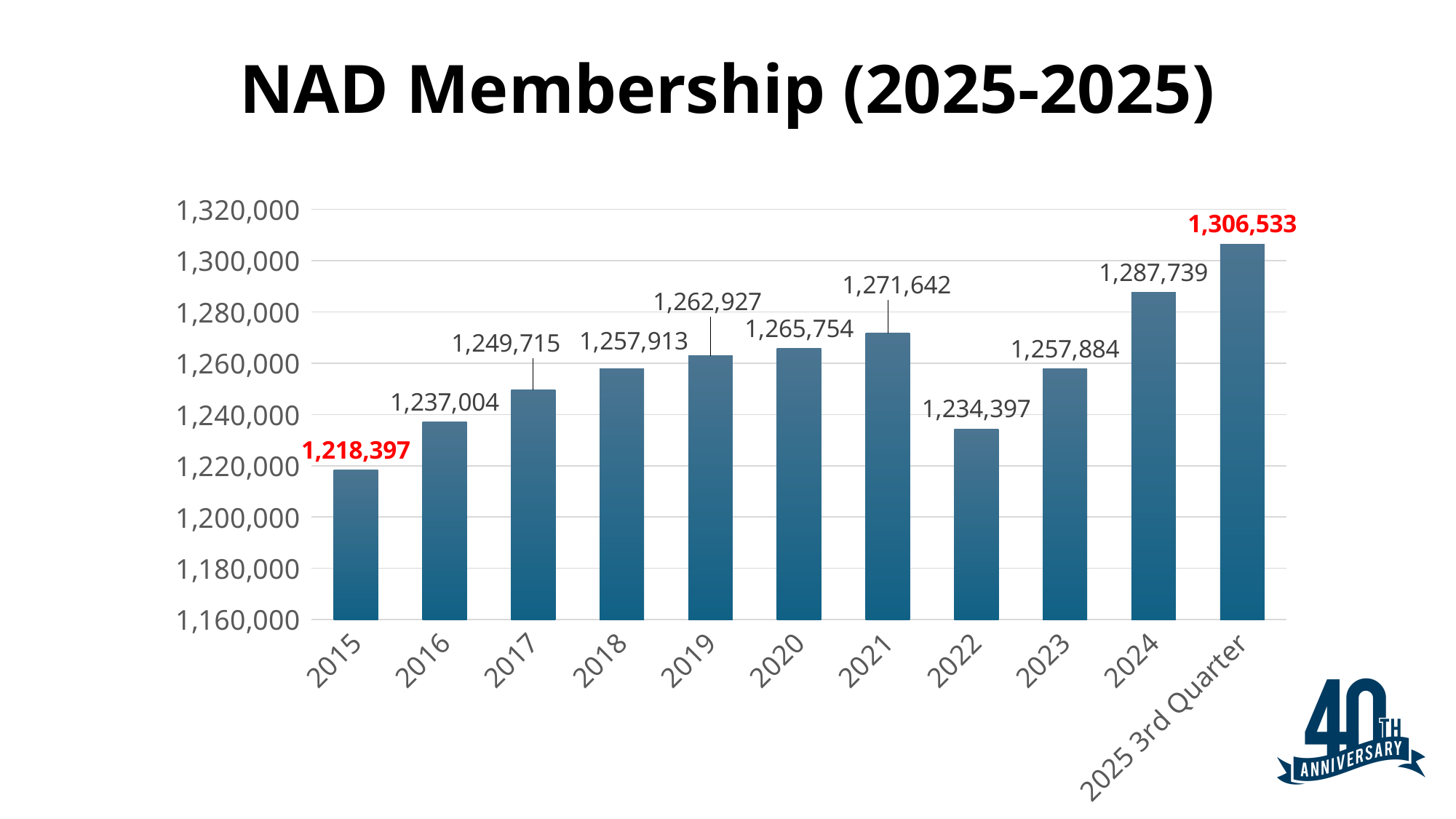
Which category has the highest membership value? 2025 3rd Quarter Is the membership value for 2024 greater or less than 1,280,000? greater What is the membership value for 2022? 1,234,397 What type of chart is shown on the slide? Bar chart What is the membership value shown for 2025 3rd Quarter? 1,306,533 What is the NAD membership value for 2015? 1,218,397 What is the membership value for 2019? 1,262,927 What is the difference between the membership in 2024 and in 2023? 29,855 Which year has the lowest membership value? 2015 What is the difference between the membership in 2025 3rd Quarter and in 2015? 88,136 Which is larger, the membership in 2021 or in 2022? 2021 How many bars are shown in the chart? 11